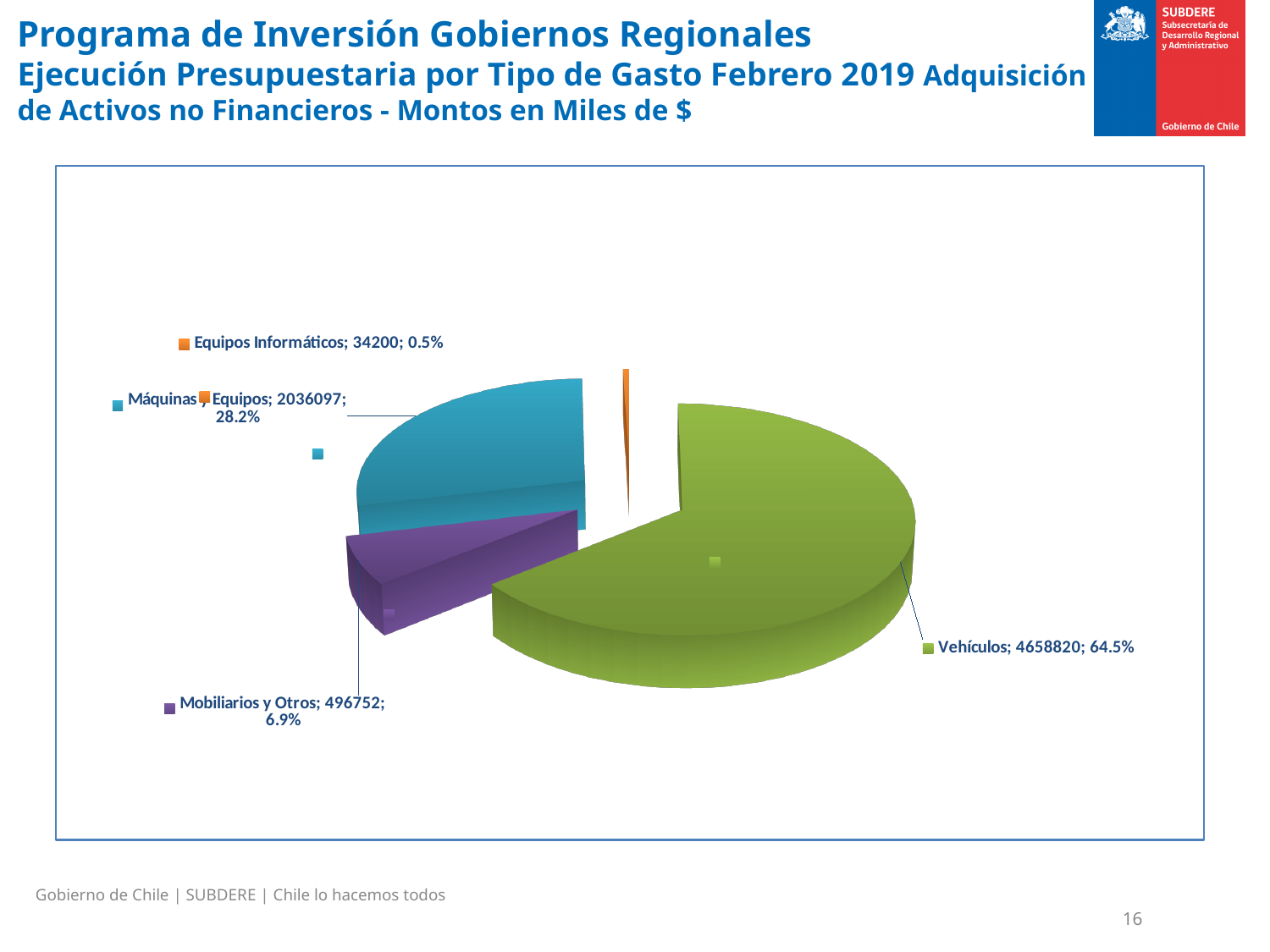
Which is larger, the value for Mobiliarios y Otros or the value for Equipos Informáticos? Mobiliarios y Otros What is the value for Mobiliarios y Otros? 496752 What is the value for Equipos Informáticos? 34200 Which category has the largest slice? Vehículos What is the value for Máquinas y Equipos? 2036097 Which category has the smallest slice? Equipos Informáticos What share of the pie does Máquinas y Equipos represent? 28.2% How many categories (slices) does the pie chart show? 4 What share of the pie does Vehículos represent? 64.5% What is the difference between the values for Vehículos and Máquinas y Equipos? 2622723 What type of chart is shown on the slide? Pie chart What is the value for Vehículos? 4658820